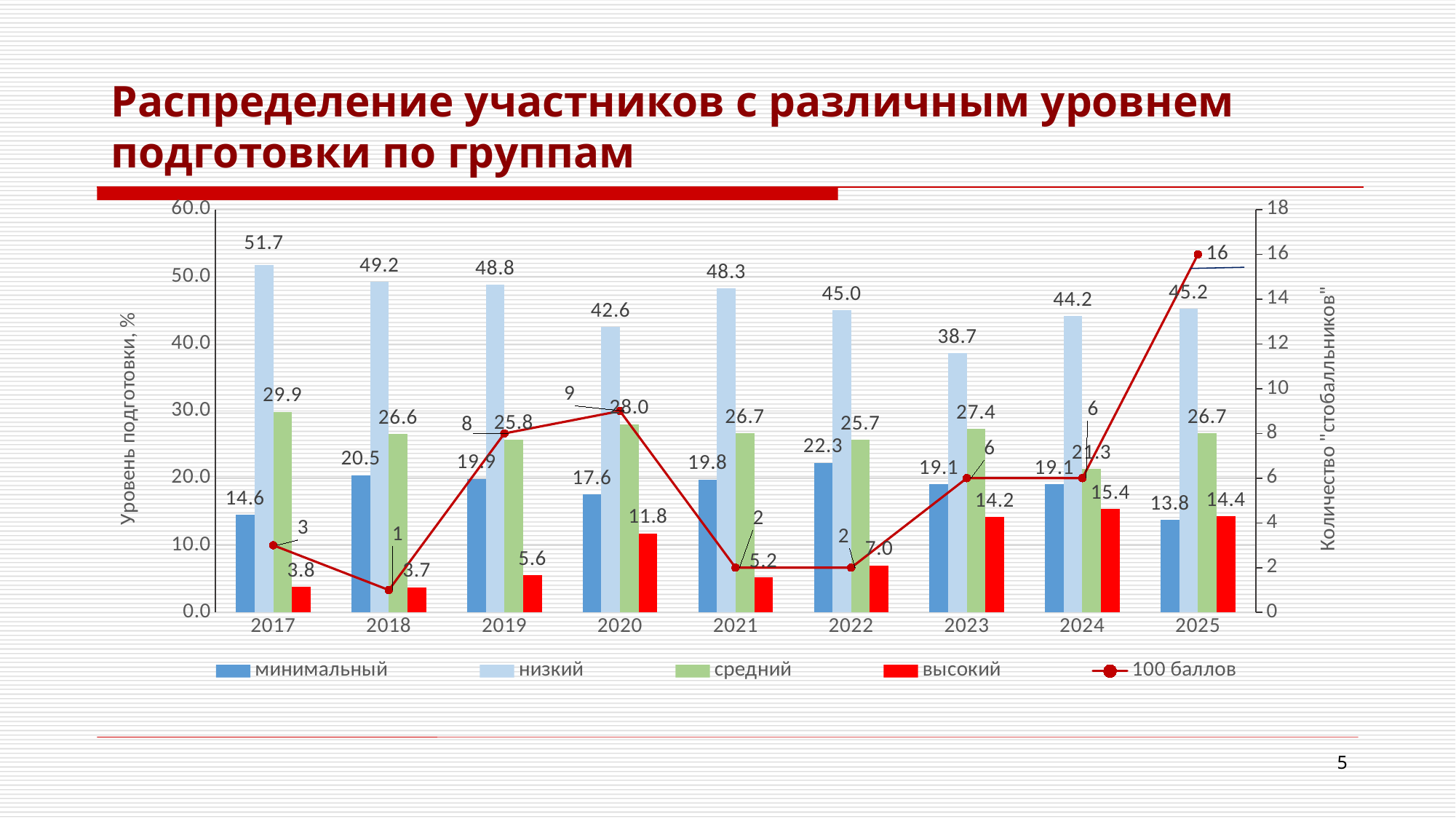
Which is larger for 2022: the средний value or the минимальный value? средний How many years are shown on the x axis? 9 What is the value of the 100 баллов line for 2025? 16 What is the label of the right-hand vertical axis? Количество "стобалльников" In which year is the низкий series at its lowest? 2023 What is the value of the средний series for 2020? 28.0 What kind of chart is this? Combined bar and line chart How many series does the legend list? 5 What is the difference between the низкий and минимальный values for 2018? 28.7 In which year is the 100 баллов line at its highest? 2025 What is the value of the низкий series for 2017? 51.7 What is the value of the высокий series for 2024? 15.4